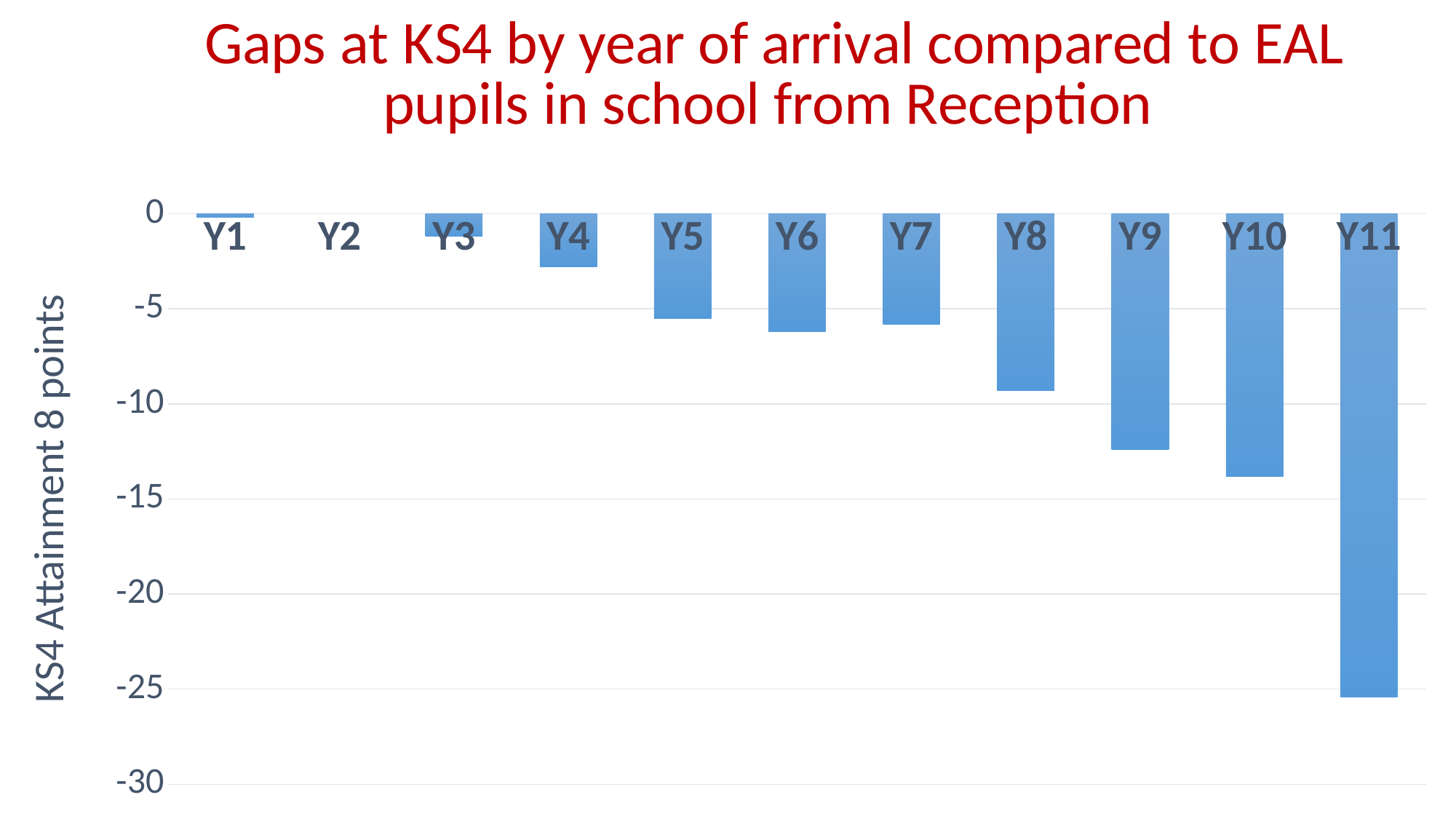
Which year of arrival has the lowest (most negative) value? Y11 Is the value for Y8 greater or less than -10? greater Is the value for Y4 greater or less than -5? greater What kind of chart is shown on the slide? bar chart How many year-of-arrival categories are shown on the x axis? 11 What is the label on the vertical axis? KS4 Attainment 8 points Do the values generally rise or fall from Y1 to Y11 along the x axis? fall Is the value for Y6 greater or less than -5? less Which bar is longer, Y9 or Y10? Y10 What is the title of the chart? Gaps at KS4 by year of arrival compared to EAL pupils in school from Reception